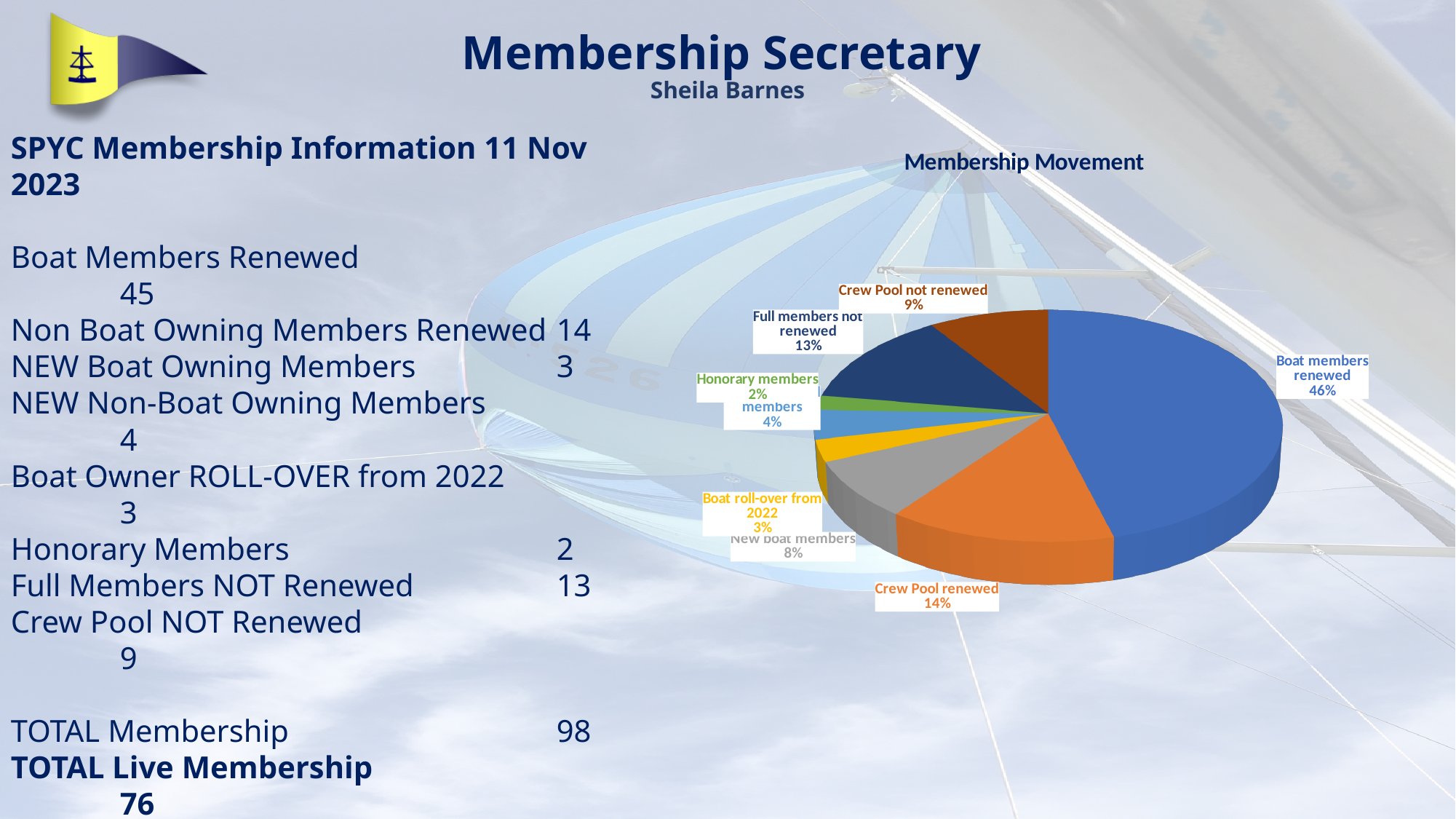
Which is larger in the pie chart, Full members not renewed or Crew Pool not renewed? Full members not renewed What share of the pie chart is Crew Pool renewed? 14% What share of the pie chart is Honorary members? 2% What share of the pie chart is Boat members renewed? 46% What is the title of the pie chart? Membership Movement What is the difference in percentage points between Boat members renewed and Crew Pool renewed? 32 What kind of chart is shown on the slide? pie chart Which slice of the pie chart is the smallest? Honorary members Which slice of the pie chart is the largest? Boat members renewed